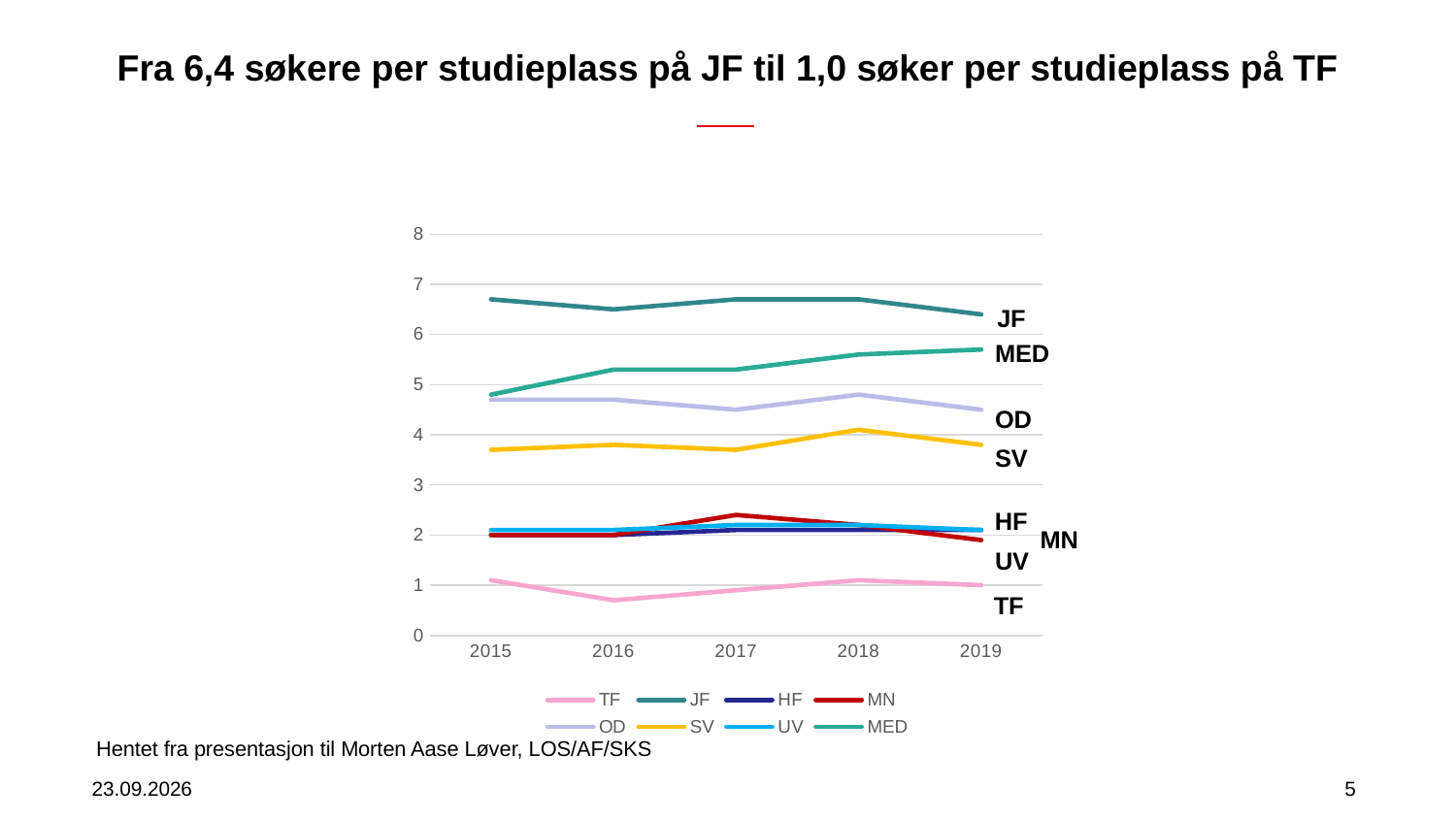
Which is larger in 2017, the value for OD or the value for SV? OD Does the MED line rise or fall from 2015 to 2019? rise Is the value for MED in 2019 greater or less than 5? greater Is the value for TF in 2016 greater or less than 1? less How many years are shown on the x axis? 5 Is the value for SV in 2015 greater or less than 4? less What is the first year shown on the x axis? 2015 How many series does the legend list? 8 What kind of chart is shown on the slide? line chart Which series has the lowest value in 2019? TF Which series has the highest value in 2019? JF